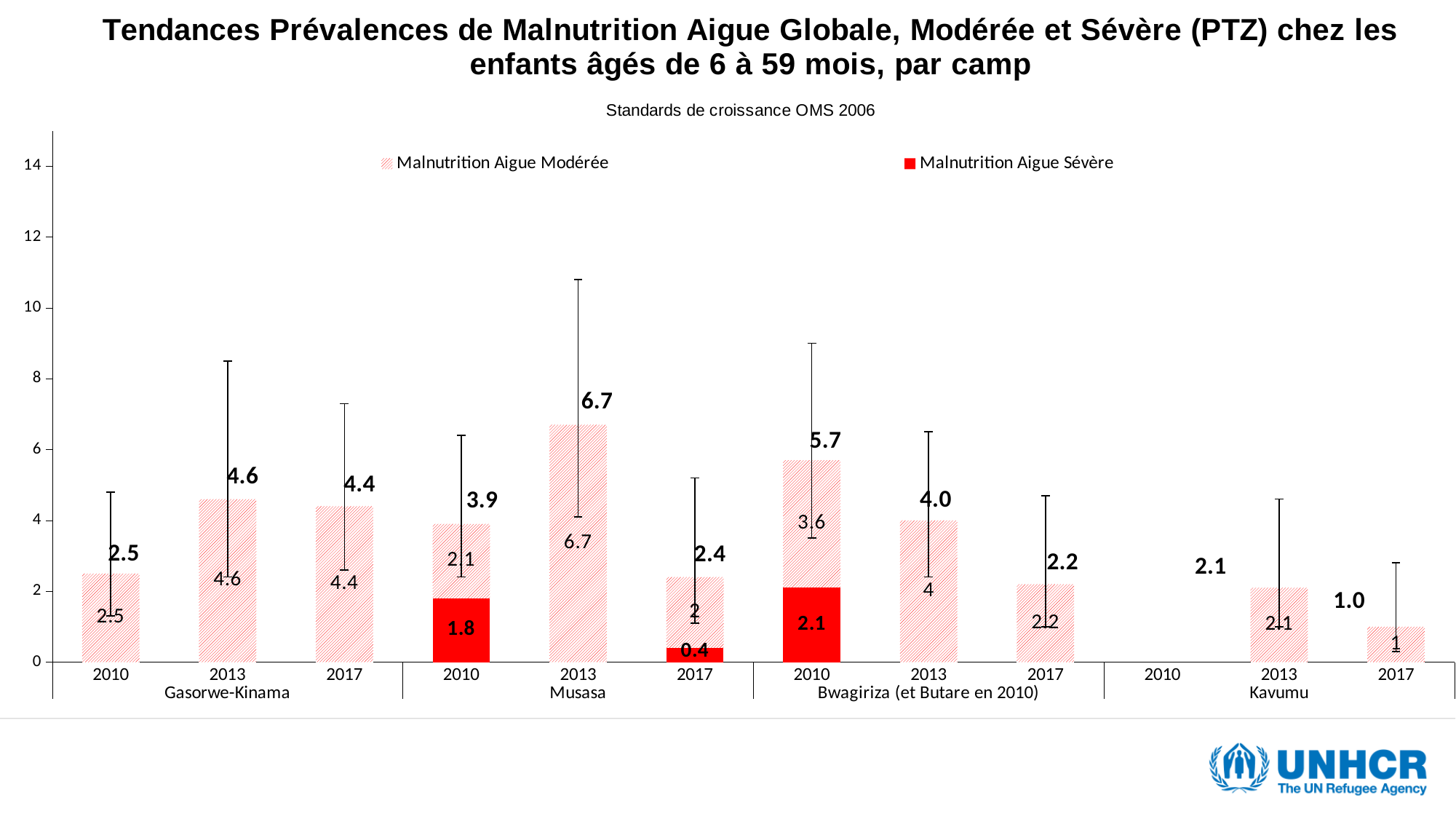
What is the Malnutrition Aigue Modérée value for Bwagiriza (et Butare en 2010) in 2010? 3.6 What is the total of the stacked bar for Musasa in 2017? 2.4 Is the total for Musasa in 2013 greater or less than 6? greater What is the Malnutrition Aigue Sévère value for Bwagiriza (et Butare en 2010) in 2010? 2.1 What is the Malnutrition Aigue Sévère value for Musasa in 2010? 1.8 What kind of chart is shown on the slide? bar chart What is the subtitle shown below the chart title? Standards de croissance OMS 2006 How many series does the legend list? 2 Which camp and year has the highest total bar? Musasa 2013 What is the difference between the Gasorwe-Kinama totals for 2013 and 2010? 2.1 Which is larger, the total for Gasorwe-Kinama in 2017 or the total for Bwagiriza (et Butare en 2010) in 2013? Gasorwe-Kinama 2017 What is the total for Kavumu in 2017? 1.0